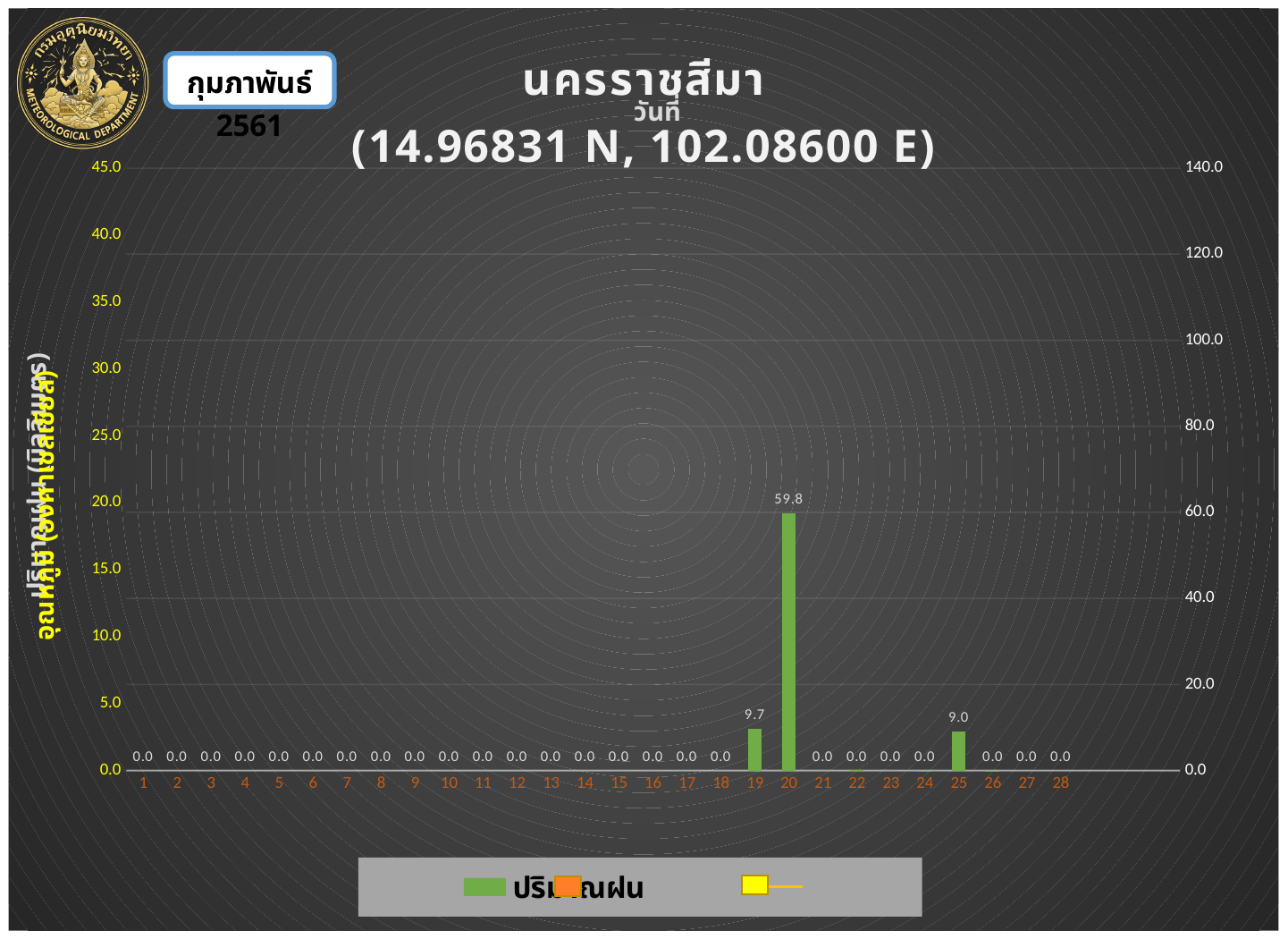
Which day has the larger rainfall value, day 19 or day 25? 19 Which month and year are shown in the box at the top left of the slide? กุมภาพันธ์ 2561 Which day has the highest rainfall value? 20 What is the rainfall value shown for day 20? 59.8 How many days are shown on the x axis of the chart? 28 What is the rainfall value shown for day 25? 9.0 What is the difference between the rainfall values for day 20 and day 19? 50.1 Is the value for day 20 greater or less than 40.0 on the right-hand axis? greater What kind of chart is shown on the slide? bar chart What is the rainfall value shown for day 10? 0.0 What is the difference between the rainfall values for day 19 and day 25? 0.7 What is the rainfall value shown for day 19? 9.7